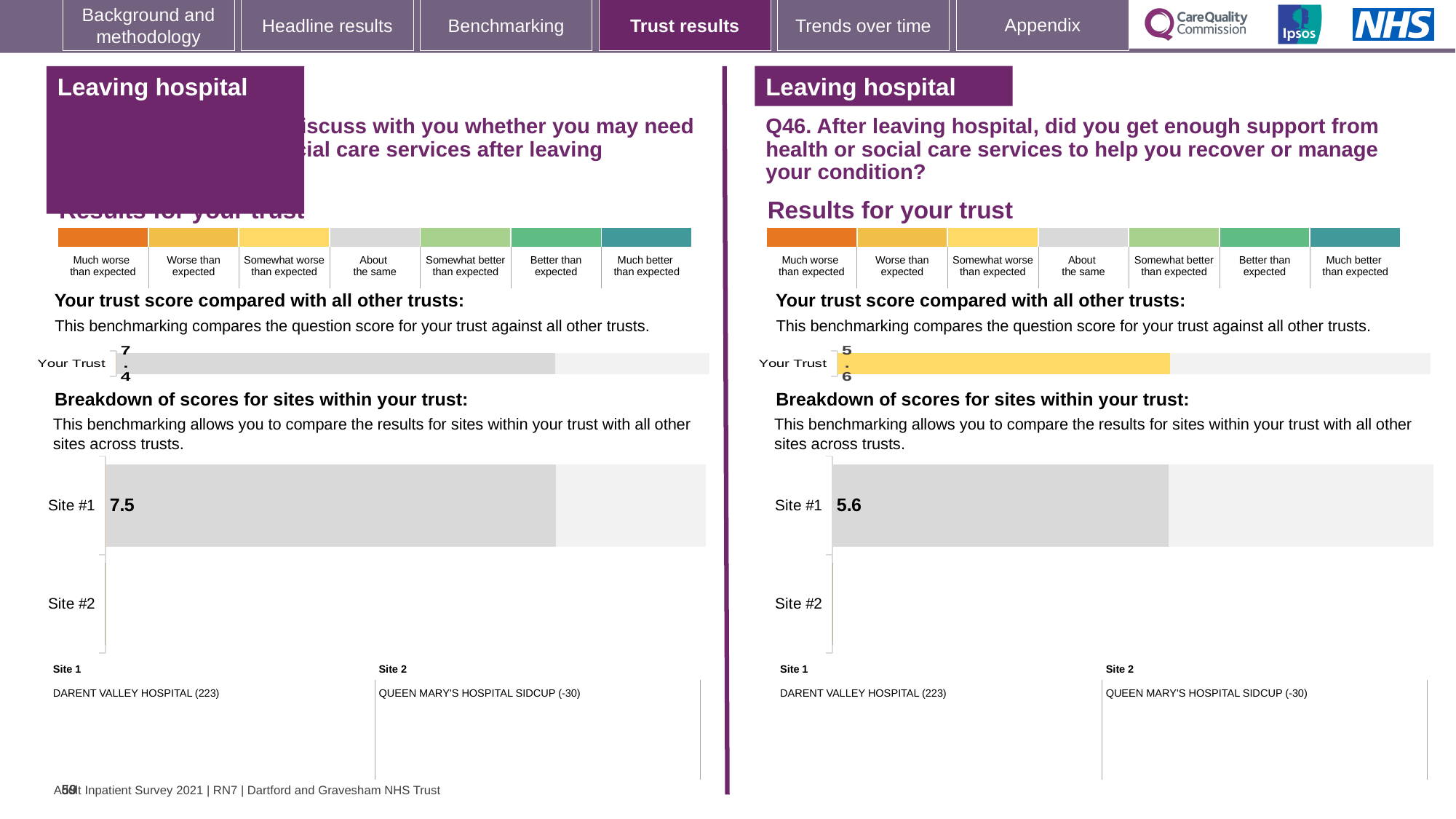
On the right-hand chart (Q46), what is the score shown for Your Trust? 5.6 On the left-hand chart, which is larger: the Site #1 score or the Your Trust score? Site #1 On the left-hand chart, what is the difference between the Site #1 score and the Your Trust score? 0.1 On the left-hand chart, what is the score shown for Your Trust? 7.4 What type of chart is used to show the Your Trust score on the right-hand side (Q46)? Bar chart On the left-hand site breakdown chart, what is the score for Site #1? 7.5 How many sites are listed in the right-hand site breakdown chart (Q46)? 2 Which has the higher Site #1 score: the left-hand chart or the right-hand chart (Q46)? Left-hand chart According to the key below the site breakdown charts, which hospital is Site 1? Darent Valley Hospital What is the difference between the Site #1 score on the left-hand chart and the Site #1 score on the right-hand chart (Q46)? 1.9 On the right-hand site breakdown chart (Q46), what is the score for Site #1? 5.6 On the right-hand chart (Q46), which benchmark category does the colour of the Your Trust bar correspond to? Somewhat worse than expected